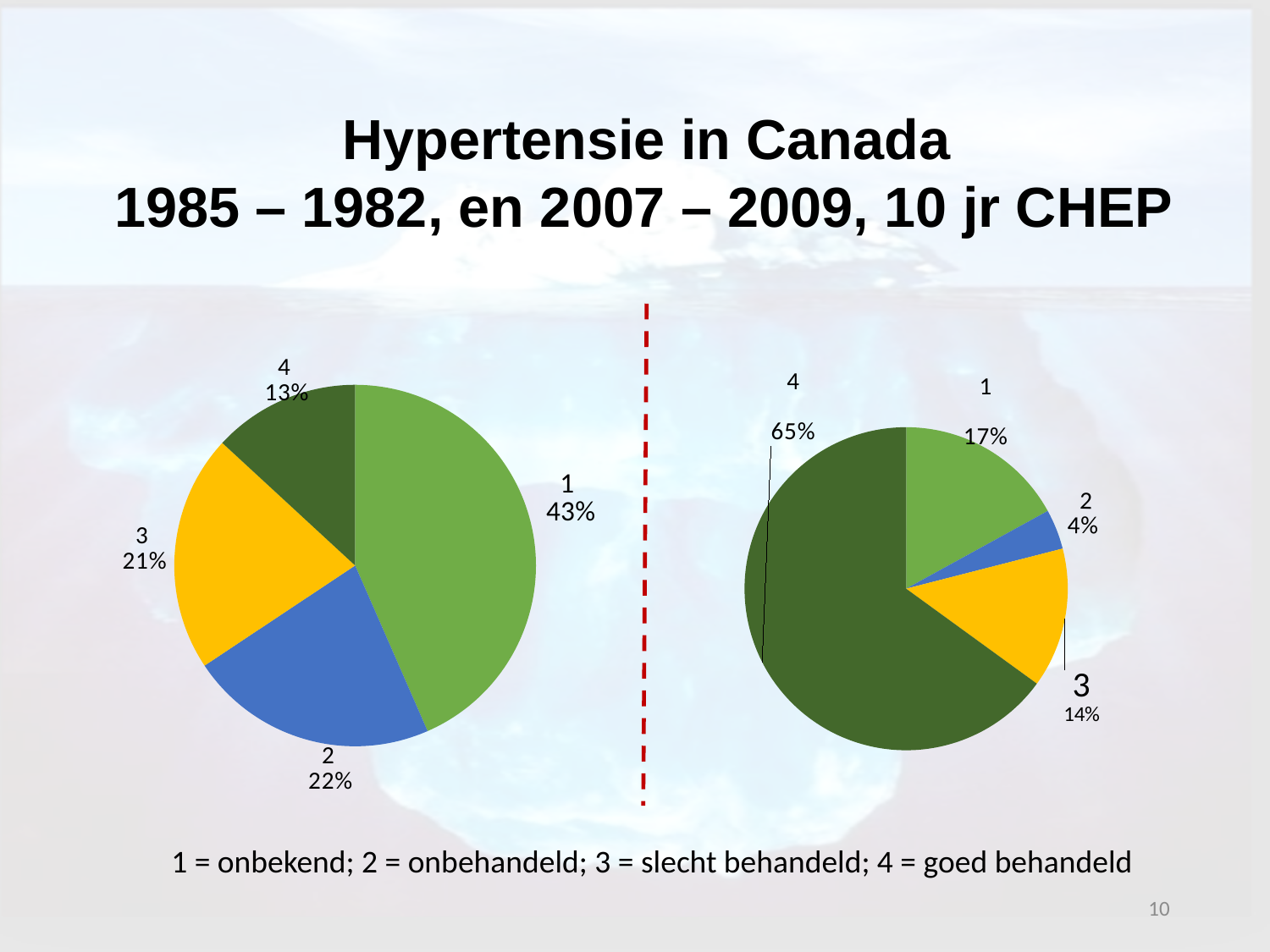
In the left pie chart, which category has the largest slice? 1 In the right pie chart, which is larger: category 1 or category 3? 1 How many slices does the left pie chart have? 4 In the right pie chart, which category has the smallest slice? 2 In the left pie chart, what share does category 1 have? 43% In the left pie chart, what is the value for category 2? 22% What type of chart is shown on the left of the slide? pie chart In the right pie chart, what share does category 4 have? 65% In the left pie chart, which category has the smallest slice? 4 What is the difference between the share of category 4 in the right pie chart and in the left pie chart? 52% According to the legend text at the bottom of the slide, what does category 4 stand for? goed behandeld In the right pie chart, what is the value for category 2? 4%